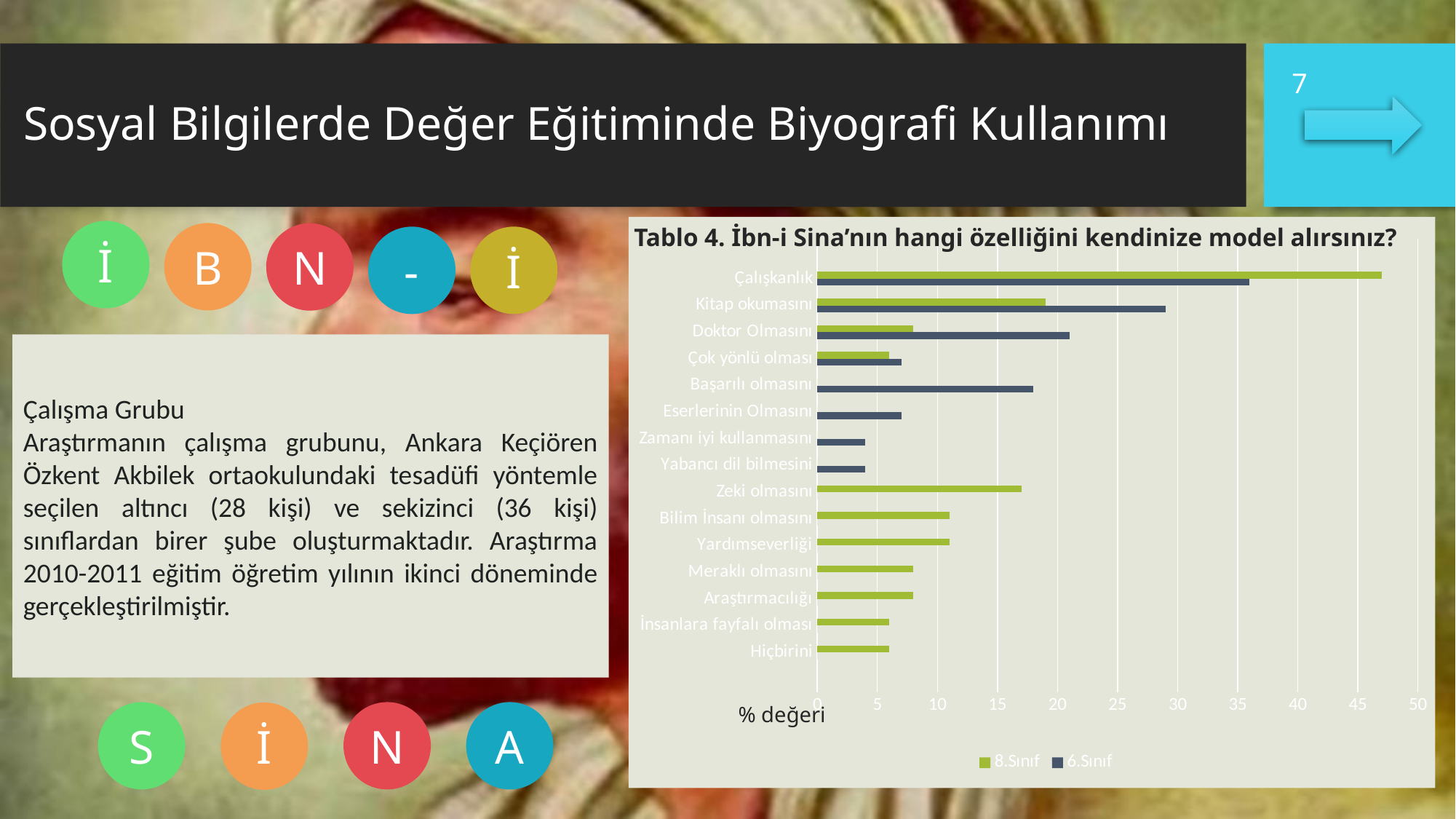
For Kitap okumasını, which series has the larger value, 8.Sınıf or 6.Sınıf? 6.Sınıf For Çalışkanlık, which series has the larger value, 8.Sınıf or 6.Sınıf? 8.Sınıf How many series does the chart legend list? 2 What kind of chart is shown on the slide? bar chart Is the 6.Sınıf value for Kitap okumasını greater or less than 25? greater Is the 8.Sınıf value for Zeki olmasını greater or less than 20? less Which category has the highest value for the 8.Sınıf series? Çalışkanlık What is the label shown on the horizontal axis of the chart? % değeri Is the 6.Sınıf value for Doktor Olmasını greater or less than 15? greater Which category has the highest value for the 6.Sınıf series? Çalışkanlık How many categories are plotted on the chart? 15